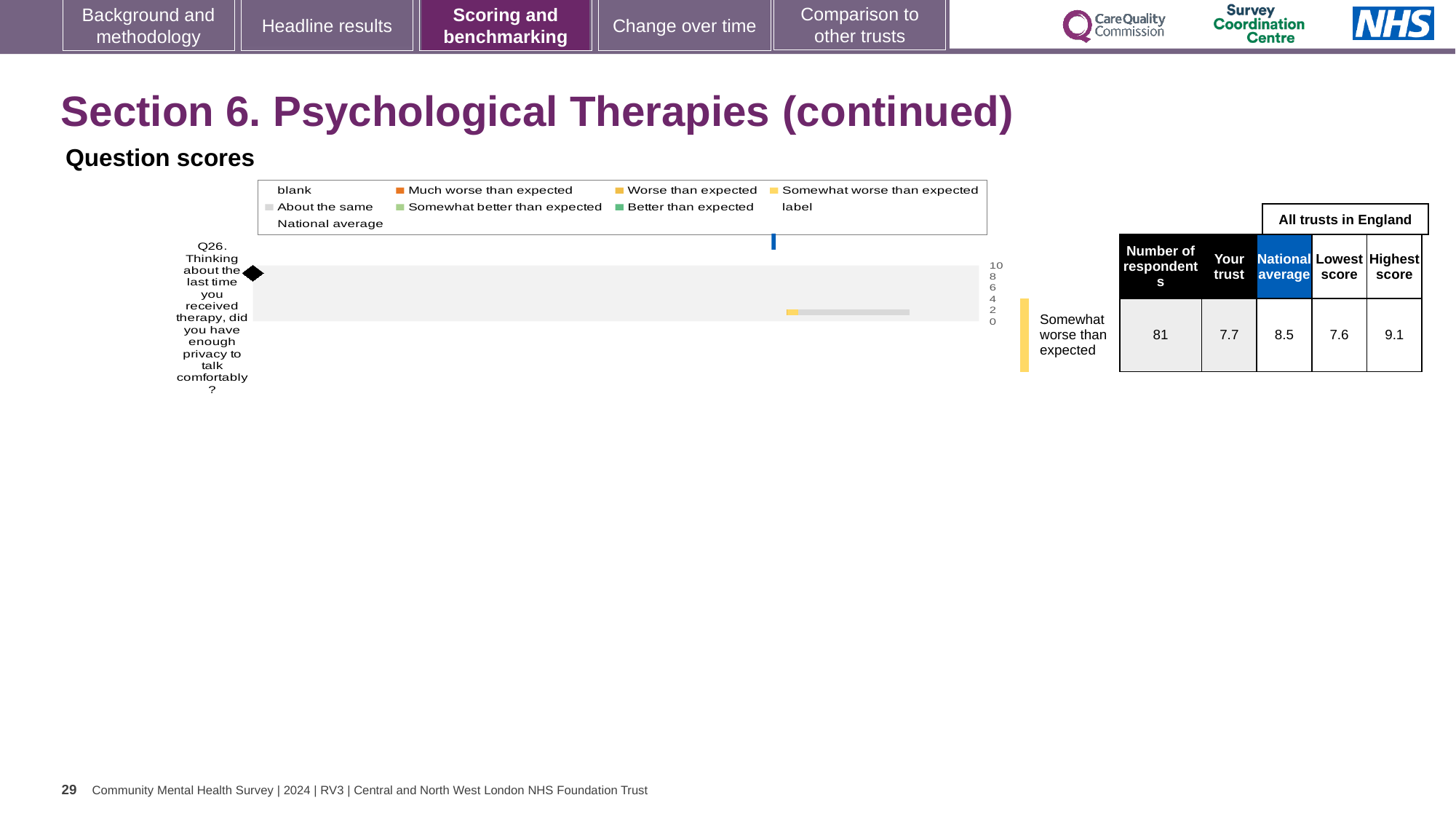
What is the 'Your trust' score for Q26? 7.7 What is the lowest score among all trusts in England for Q26? 7.6 What is the difference between the national average and the 'Your trust' score for Q26? 0.8 Which is larger for Q26, the 'Your trust' score or the national average? National average Is the 'Your trust' score for Q26 greater or less than 8? less What is the difference between the highest and lowest scores for Q26? 1.5 How many questions are plotted in the Question scores chart? 1 What kind of chart is used to show the Q26 question score? bar chart What benchmark category is shown next to the Q26 bar? Somewhat worse than expected What is the highest score among all trusts in England for Q26? 9.1 What is the national average score for Q26? 8.5 How many respondents answered Q26? 81